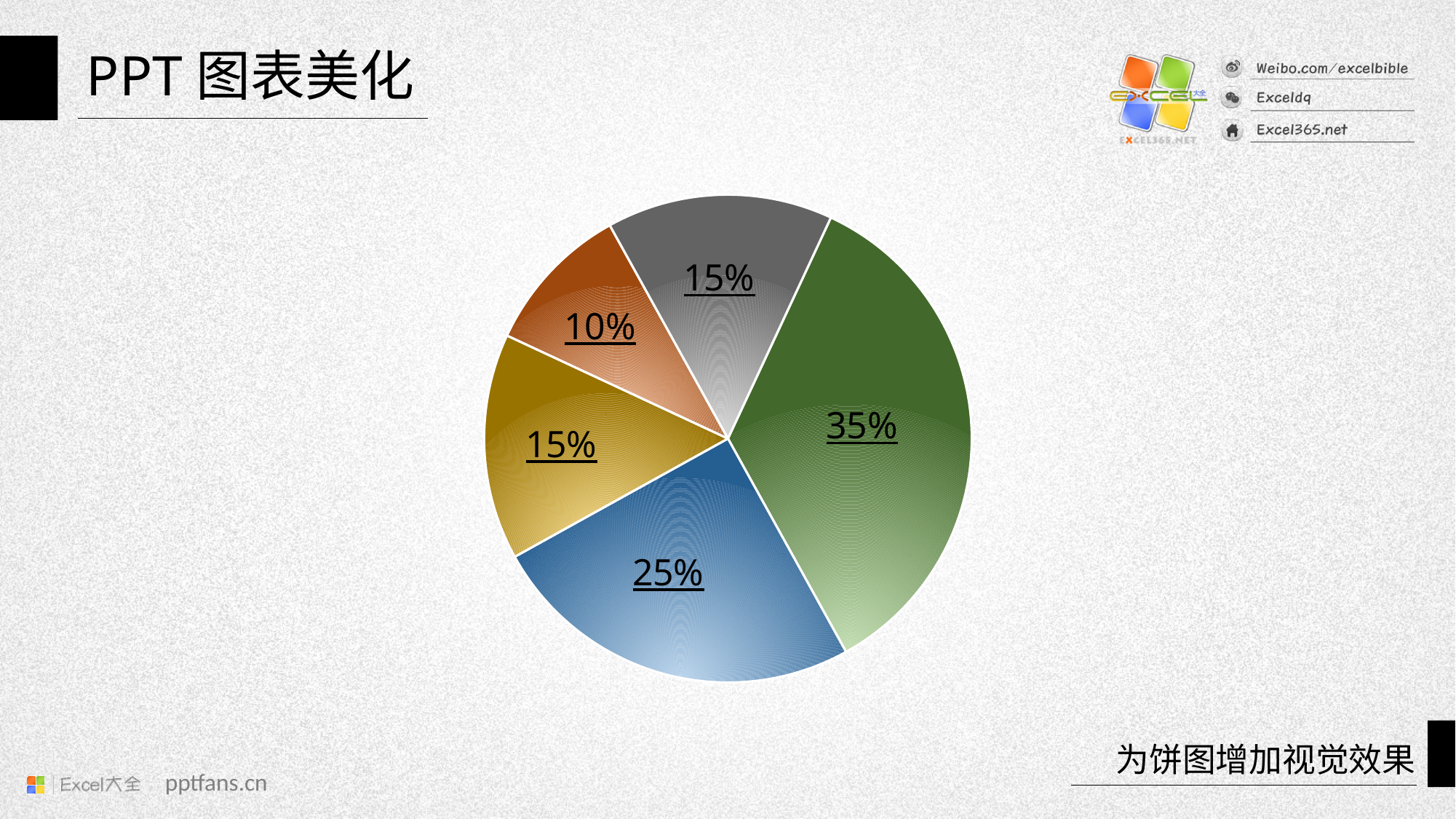
What is the difference between the green slice and the blue slice in the pie chart? 10% What percentage is shown on the blue slice of the pie chart? 25% How many slices does the pie chart have? 5 Does the pie chart have a legend? No Which is larger in the pie chart, the blue slice or the gold slice? blue What kind of chart is shown on the slide? pie chart What percentage is shown on the orange slice of the pie chart? 10% Which colour slice is the largest in the pie chart? green What percentage is shown on the green slice of the pie chart? 35% What percentage is shown on the gray slice of the pie chart? 15% Which colour slice is the smallest in the pie chart? orange What is the combined share of the gold and gray slices in the pie chart? 30%